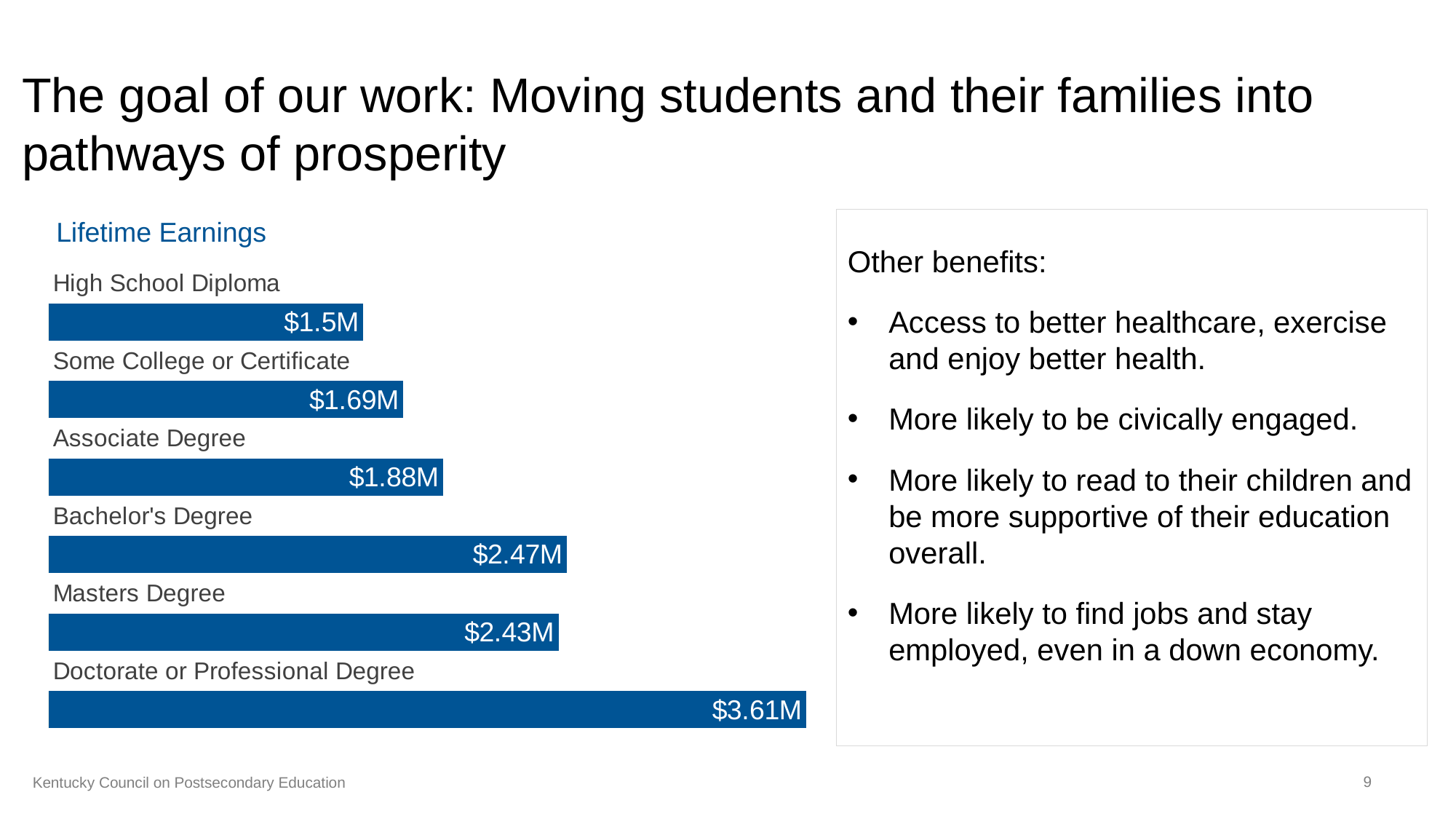
What is the lifetime earnings value for a Bachelor's Degree? $2.47M How many education categories are shown in the chart? 6 Which category has the lowest lifetime earnings? High School Diploma What is the difference in lifetime earnings between a Doctorate or Professional Degree and a Bachelor's Degree? $1.14M What is the difference in lifetime earnings between Some College or Certificate and a High School Diploma? $0.19M What type of chart is used to show lifetime earnings? Bar chart Which has higher lifetime earnings: Bachelor's Degree or Masters Degree? Bachelor's Degree Which category has the highest lifetime earnings? Doctorate or Professional Degree Which has higher lifetime earnings: Associate Degree or Some College or Certificate? Associate Degree What is the lifetime earnings value for a High School Diploma? $1.5M What is the lifetime earnings value for an Associate Degree? $1.88M What is the title of the chart? Lifetime Earnings